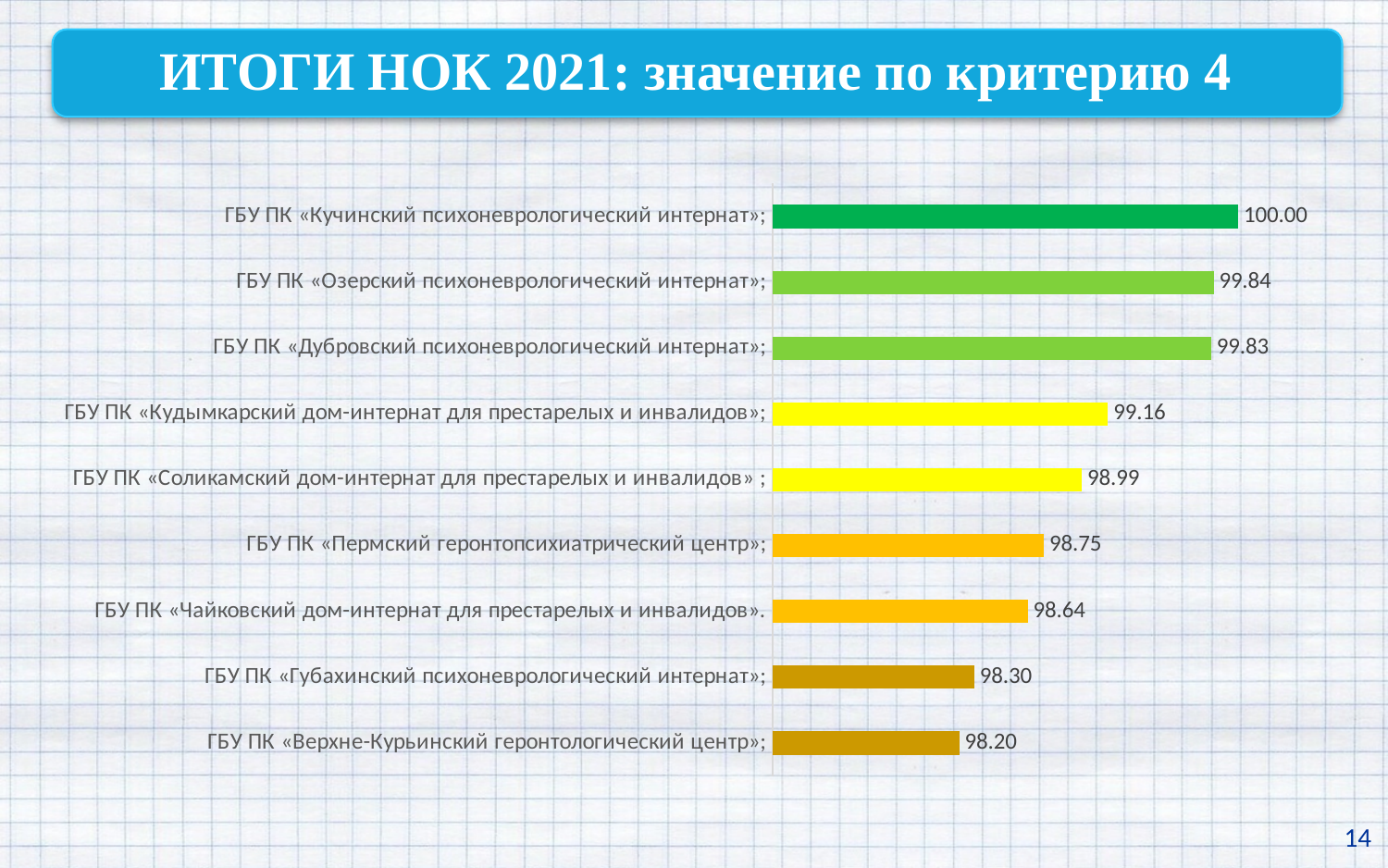
Which organisation has the lowest value? ГБУ ПК «Верхне-Курьинский геронтологический центр» What is the difference between the values for ГБУ ПК «Кучинский психоневрологический интернат» and ГБУ ПК «Верхне-Курьинский геронтологический центр»? 1.80 What is the value for ГБУ ПК «Губахинский психоневрологический интернат»? 98.30 What is the value for ГБУ ПК «Кучинский психоневрологический интернат»? 100.00 Which has a larger value: ГБУ ПК «Озерский психоневрологический интернат» or ГБУ ПК «Пермский геронтопсихиатрический центр»? ГБУ ПК «Озерский психоневрологический интернат» How many organisations are shown in the chart? 9 What is the difference between the values for ГБУ ПК «Кудымкарский дом-интернат для престарелых и инвалидов» and ГБУ ПК «Чайковский дом-интернат для престарелых и инвалидов»? 0.52 What kind of chart is shown on the slide? Bar chart Which organisation has the highest value? ГБУ ПК «Кучинский психоневрологический интернат» What is the value for ГБУ ПК «Соликамский дом-интернат для престарелых и инвалидов»? 98.99 What is the title of the slide? ИТОГИ НОК 2021: значение по критерию 4 What is the value for ГБУ ПК «Пермский геронтопсихиатрический центр»? 98.75